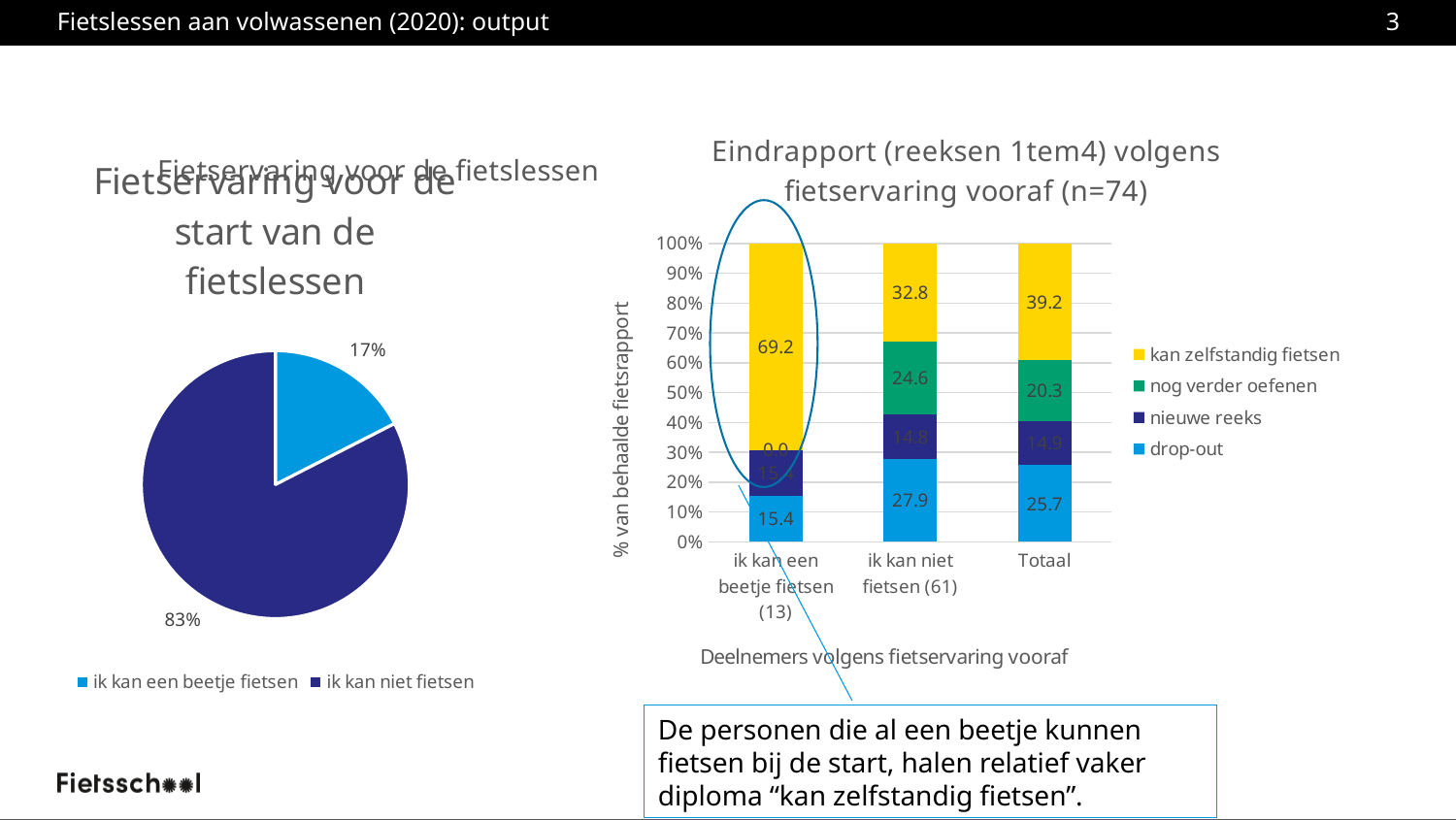
In the "Eindrapport (reeksen 1tem4) volgens fietservaring vooraf (n=74)" chart, what is the value of "drop-out" for "ik kan niet fietsen (61)"? 27.9 What kind of chart is the "Eindrapport (reeksen 1tem4) volgens fietservaring vooraf (n=74)" chart? Stacked bar chart How many series does the legend of the "Eindrapport (reeksen 1tem4) volgens fietservaring vooraf (n=74)" chart list? 4 In the "Eindrapport (reeksen 1tem4) volgens fietservaring vooraf (n=74)" chart, what is the value of "kan zelfstandig fietsen" for "ik kan een beetje fietsen (13)"? 69.2 How many categories are shown on the x axis of the "Eindrapport (reeksen 1tem4) volgens fietservaring vooraf (n=74)" chart? 3 In the pie chart on the left, what percentage is shown for "ik kan een beetje fietsen"? 17% How many slices does the pie chart on the left have? 2 In the "Eindrapport (reeksen 1tem4) volgens fietservaring vooraf (n=74)" chart, what is the difference between the "kan zelfstandig fietsen" values for "Totaal" and "ik kan niet fietsen (61)"? 6.4 In the pie chart on the left, what percentage is shown for "ik kan niet fietsen"? 83% In the "Eindrapport (reeksen 1tem4) volgens fietservaring vooraf (n=74)" chart, what is the value of "nog verder oefenen" for "Totaal"? 20.3 In the "Eindrapport (reeksen 1tem4) volgens fietservaring vooraf (n=74)" chart, which category has the highest value for "kan zelfstandig fietsen"? ik kan een beetje fietsen (13) What kind of chart is the chart on the left of the slide? Pie chart